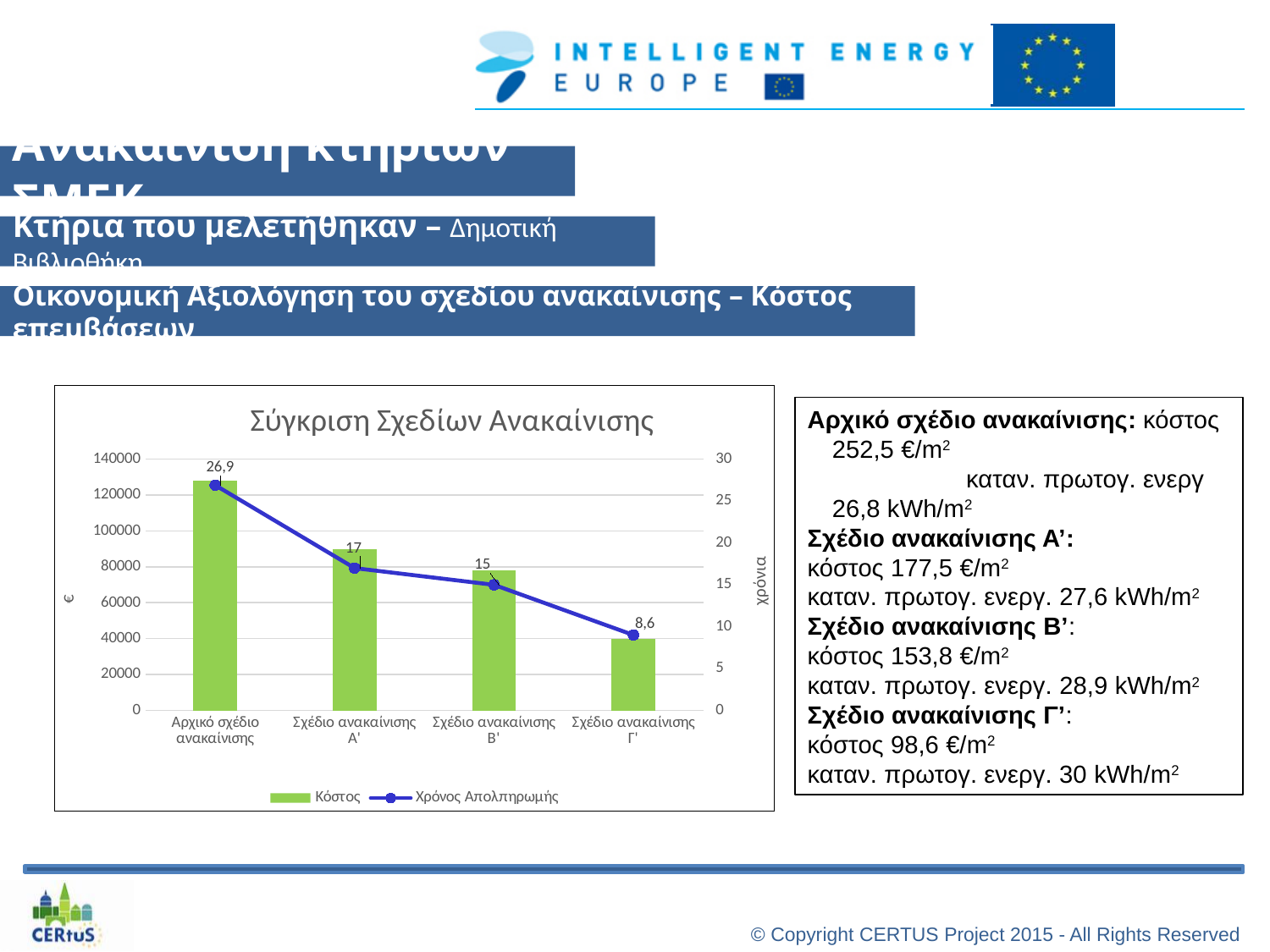
Which category has the highest Χρόνος Απολπηρωμής? Αρχικό σχέδιο ανακαίνισης What is the Χρόνος Απολπηρωμής value for Αρχικό σχέδιο ανακαίνισης? 26,9 How many categories are shown on the x axis of the chart? 4 What is the Χρόνος Απολπηρωμής value for Σχέδιο ανακαίνισης Α'? 17 How many series does the chart legend list? 2 Do the Χρόνος Απολπηρωμής values rise or fall from left to right along the x axis? fall Which has a larger Χρόνος Απολπηρωμής, Σχέδιο ανακαίνισης Α' or Σχέδιο ανακαίνισης Β'? Σχέδιο ανακαίνισης Α' What is the difference in Χρόνος Απολπηρωμής between Αρχικό σχέδιο ανακαίνισης and Σχέδιο ανακαίνισης Γ'? 18,3 Which category has the lowest Κόστος? Σχέδιο ανακαίνισης Γ' What is the Χρόνος Απολπηρωμής value for Σχέδιο ανακαίνισης Γ'? 8,6 Is the Κόστος value for Αρχικό σχέδιο ανακαίνισης greater or less than 120000? greater Is the Κόστος value for Σχέδιο ανακαίνισης Γ' greater or less than 60000? less